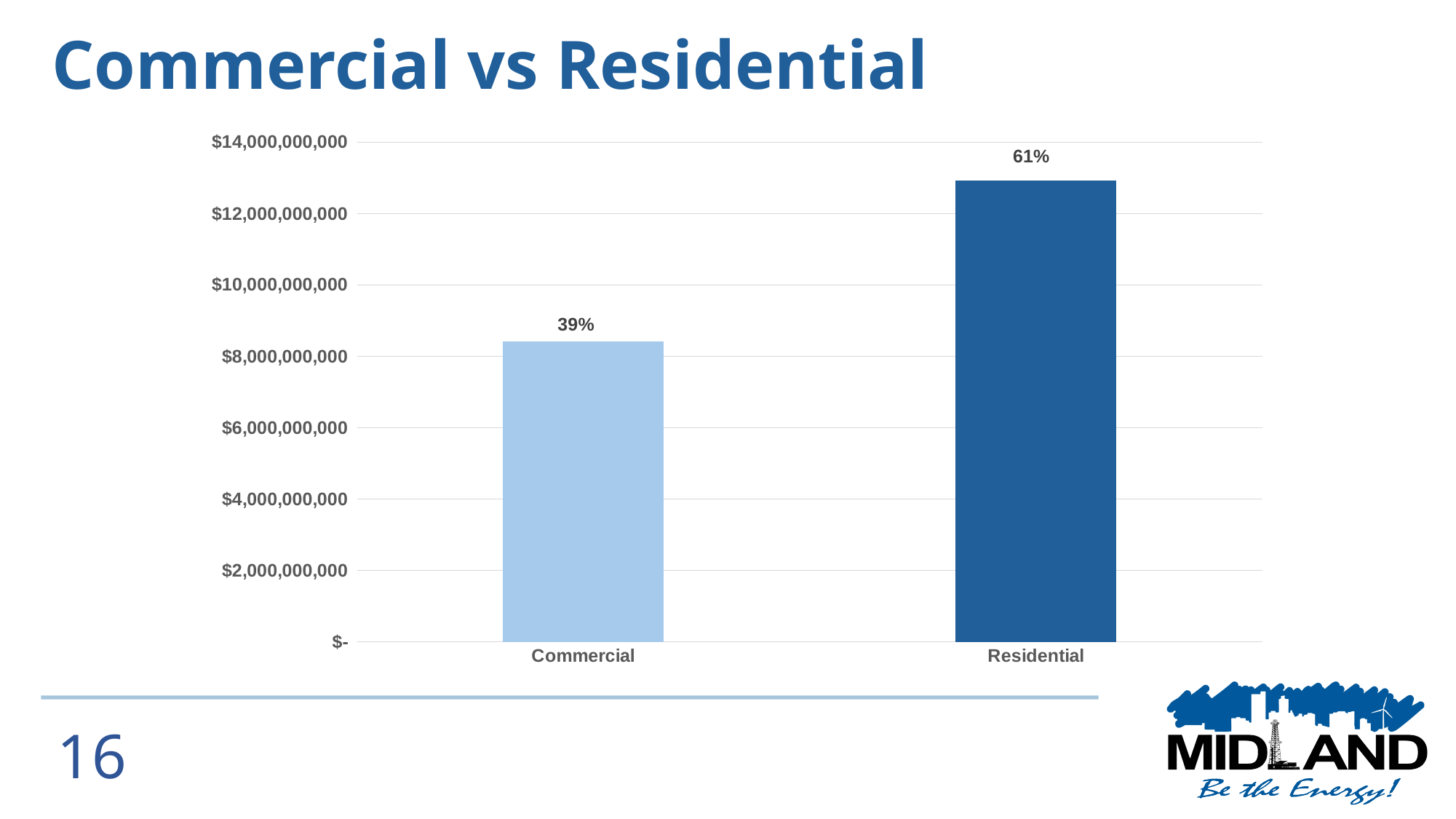
What percentage label is shown above the Commercial bar? 39% Is the value for Commercial greater or less than $8,000,000,000? greater Which bar is taller, Commercial or Residential? Residential How many categories are plotted in the chart? 2 What kind of chart is shown on the slide? bar chart What is the title of the slide's chart? Commercial vs Residential Which category has the lowest bar? Commercial Is the value for Residential greater or less than $12,000,000,000? greater What percentage label is shown above the Residential bar? 61% What is the difference in percentage points between the Residential and Commercial labels? 22% Which category has the highest bar? Residential Is the value for Commercial greater or less than $10,000,000,000? less